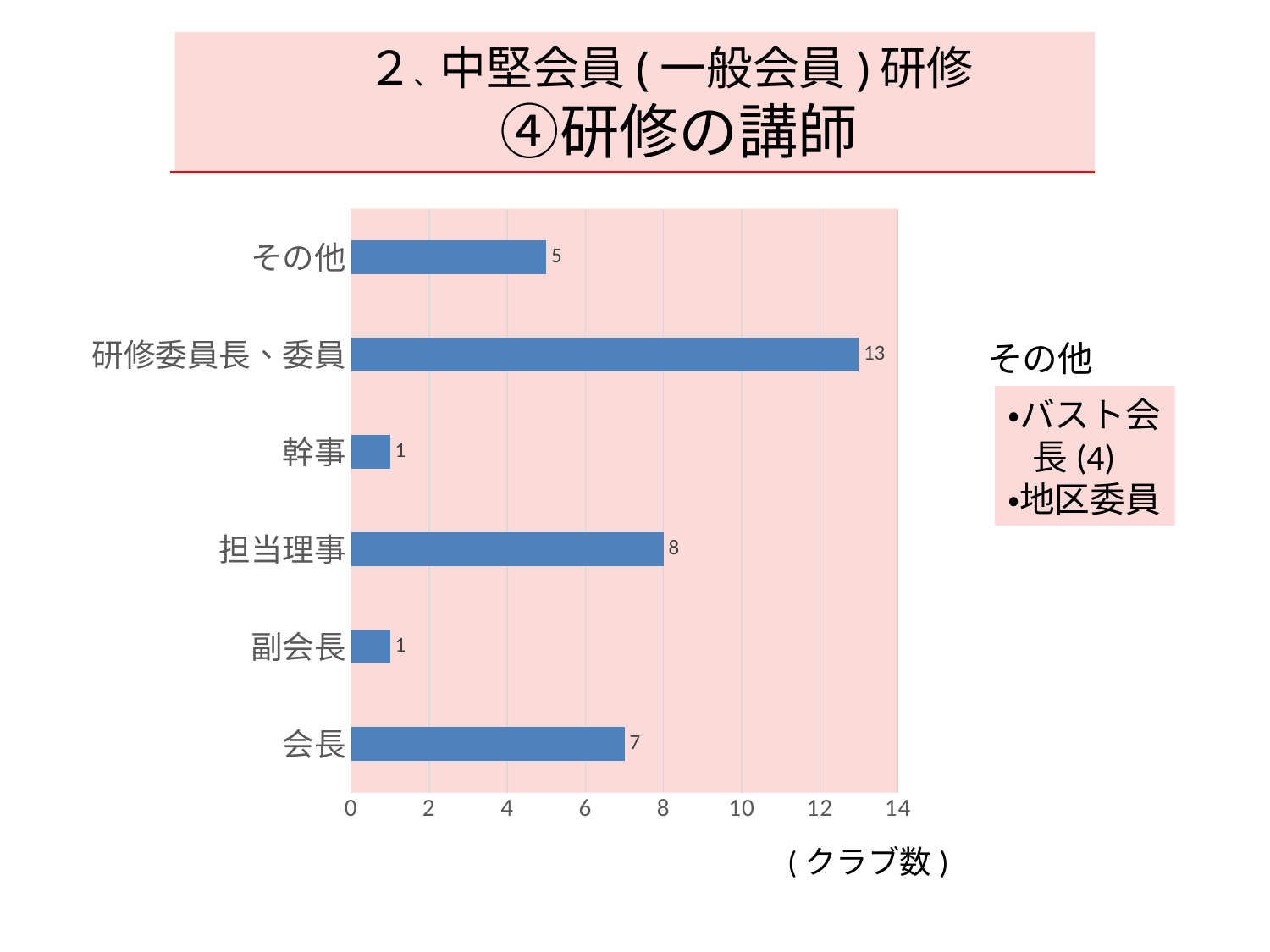
How many categories are shown in the chart? 6 What is the value for 会長? 7 Is the value for 研修委員長、委員 greater or less than 12? greater What is the value for 担当理事? 8 What is the value for その他? 5 What kind of chart is shown on the slide? bar chart What is the difference between the values for 研修委員長、委員 and 担当理事? 5 Which category has the highest value? 研修委員長、委員 Which is larger, the value for 会長 or the value for 担当理事? 担当理事 What is the maximum value shown on the horizontal axis? 14 What is the difference between the values for 会長 and 副会長? 6 What is the value for 研修委員長、委員? 13